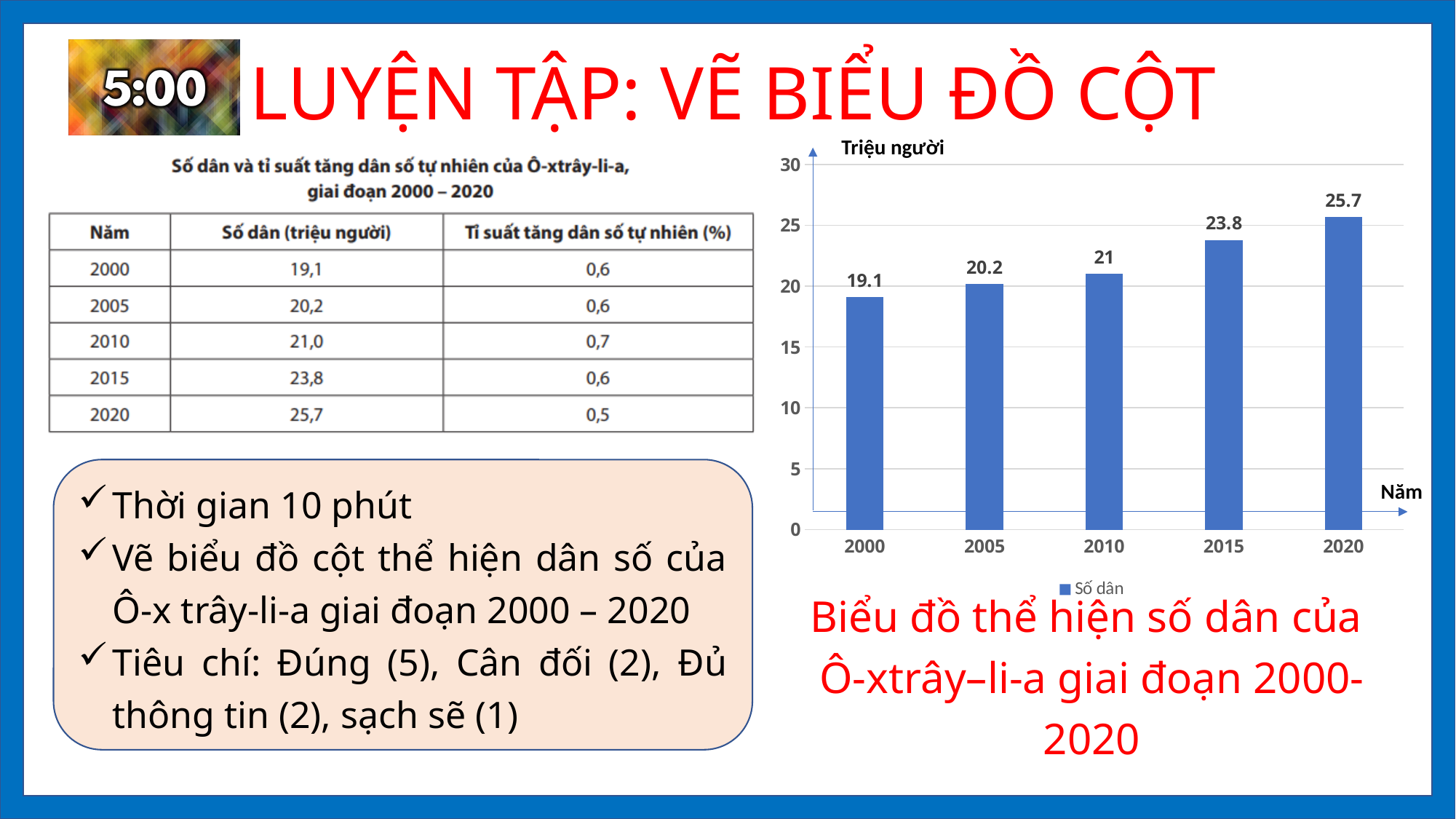
What kind of chart is shown on the slide? bar chart Which is larger in the bar chart, the value for 2005 or the value for 2015? 2015 What is the value for 2020 in the bar chart? 25.7 How many years are shown on the x axis of the bar chart? 5 Do the values in the bar chart rise or fall from 2000 to 2020? rise What is the difference between the values for 2015 and 2005 in the bar chart? 3.6 Which year has the highest value in the bar chart? 2020 How many series does the legend of the bar chart list? 1 What is the difference between the values for 2020 and 2000 in the bar chart? 6.6 What is the value for 2000 in the bar chart? 19.1 What is the value for 2010 in the bar chart? 21 Which year has the lowest value in the bar chart? 2000